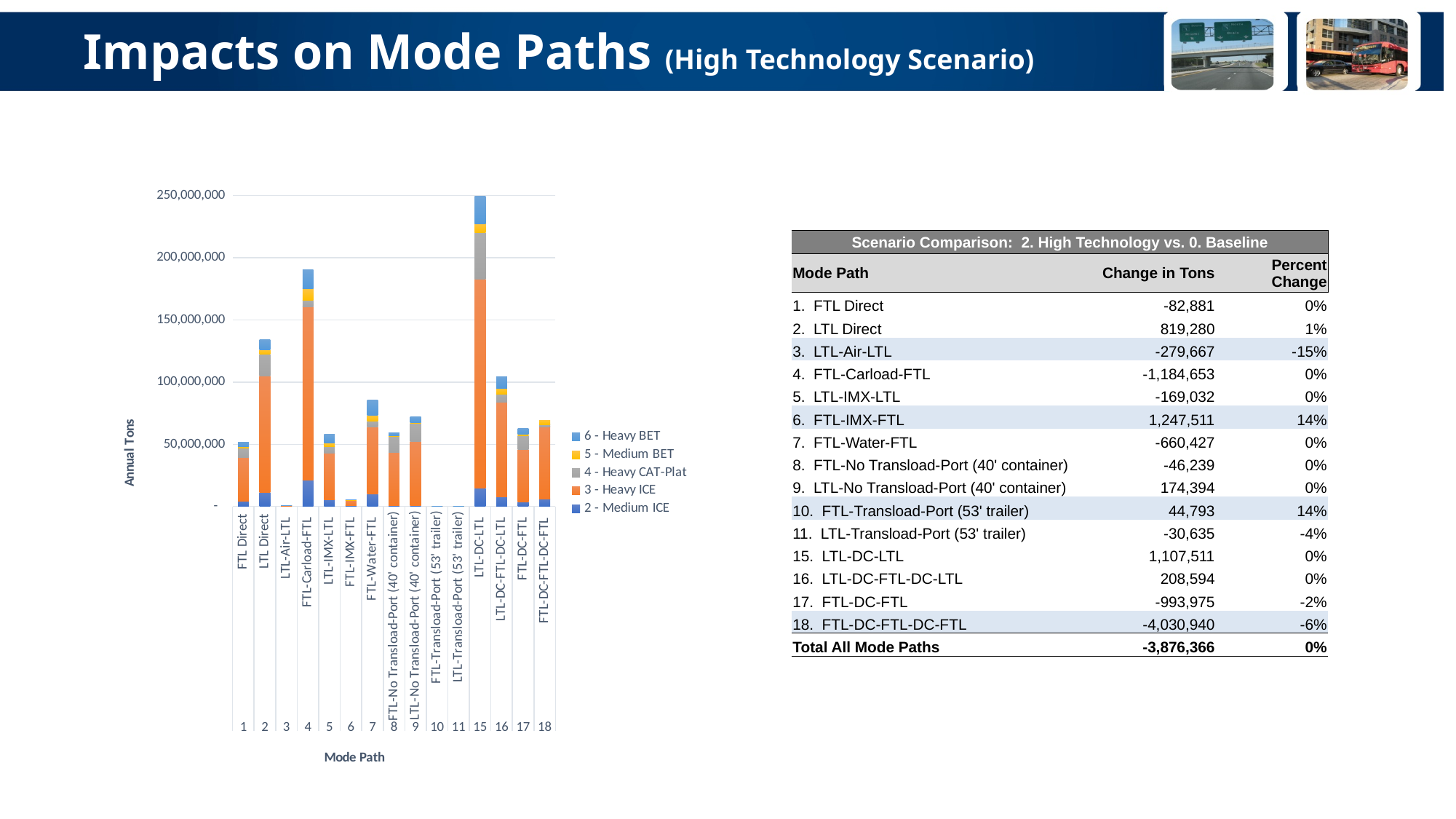
What kind of chart is shown on the slide? Stacked bar chart Which mode path has the tallest stacked bar in the chart? LTL-DC-LTL Which has the taller stacked bar, LTL-DC-FTL-DC-LTL or FTL-DC-FTL? LTL-DC-FTL-DC-LTL Is the total bar for FTL-Carload-FTL greater or less than 150,000,000? greater Which has the taller stacked bar, FTL-Carload-FTL or LTL Direct? FTL-Carload-FTL What is the label on the vertical axis of the chart? Annual Tons Which colour represents the series '3 - Heavy ICE' in the chart legend? Orange How many mode path categories are plotted on the x axis of the chart? 15 How many series does the chart legend list? 5 Is the total bar for FTL-Water-FTL greater or less than 100,000,000? less Is the total bar for LTL-DC-LTL greater or less than 200,000,000? greater